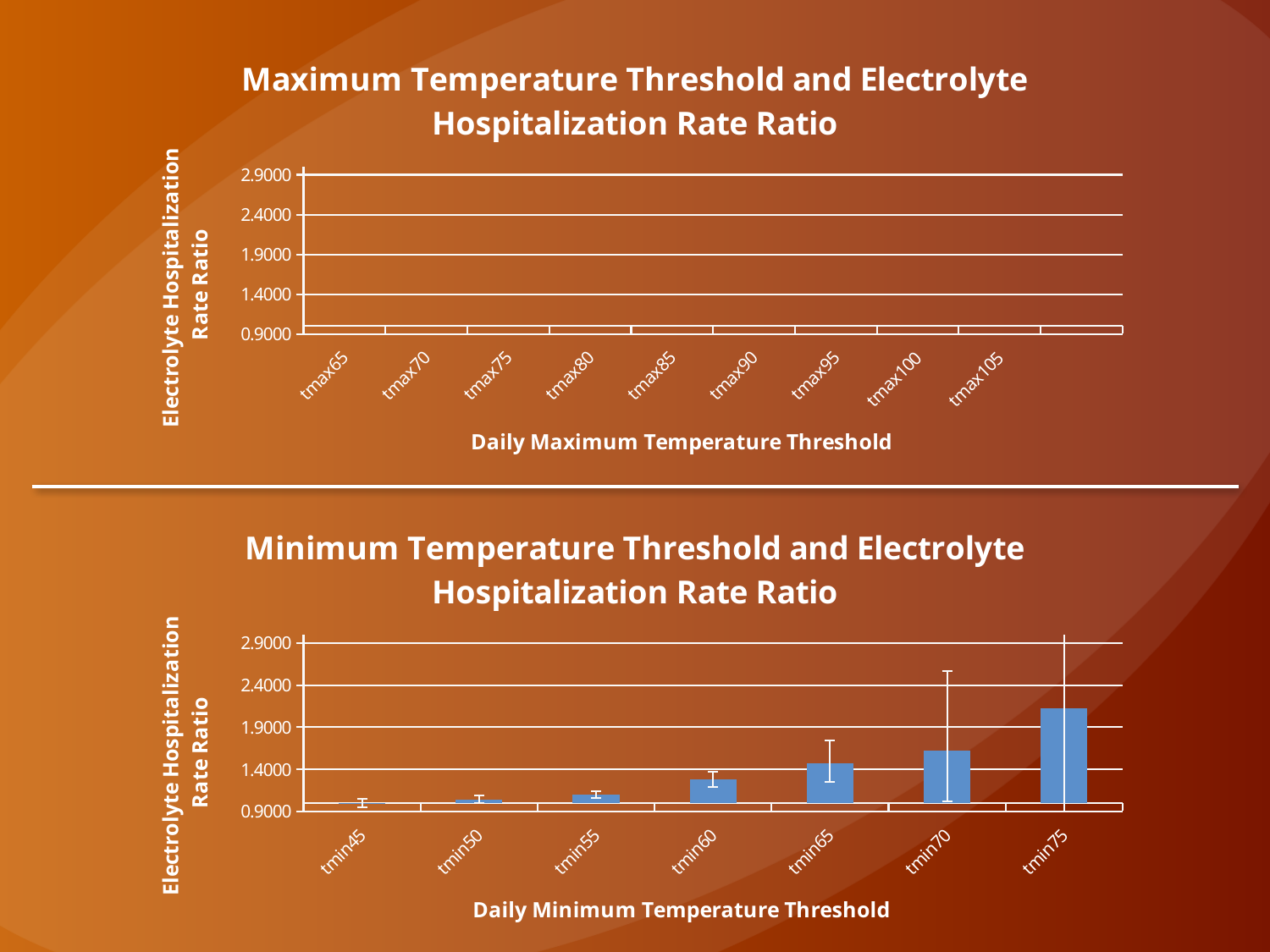
In the bottom chart (Minimum Temperature Threshold), is the value for tmin75 greater or less than 2.4000? less In the bottom chart (Minimum Temperature Threshold), do the rate ratios rise or fall as the threshold increases from tmin45 to tmin75? Rise In the bottom chart (Minimum Temperature Threshold), which is larger, the value for tmin70 or the value for tmin75? tmin75 In the bottom chart (Minimum Temperature Threshold), is the value for tmin70 greater or less than 1.4000? greater In the bottom chart (Minimum Temperature Threshold), is the value for tmin60 greater or less than 1.4000? less In the top chart (Maximum Temperature Threshold), how many temperature threshold categories are listed on the x axis? 9 In the bottom chart (Minimum Temperature Threshold), which category has the highest hospitalization rate ratio? tmin75 What is the x-axis title of the top chart (Maximum Temperature Threshold)? Daily Maximum Temperature Threshold In the bottom chart (Minimum Temperature Threshold), how many temperature threshold categories are shown on the x axis? 7 In the bottom chart (Minimum Temperature Threshold and Electrolyte Hospitalization Rate Ratio), what kind of chart is shown? Bar chart In the bottom chart (Minimum Temperature Threshold), which is larger, the value for tmin65 or the value for tmin60? tmin65